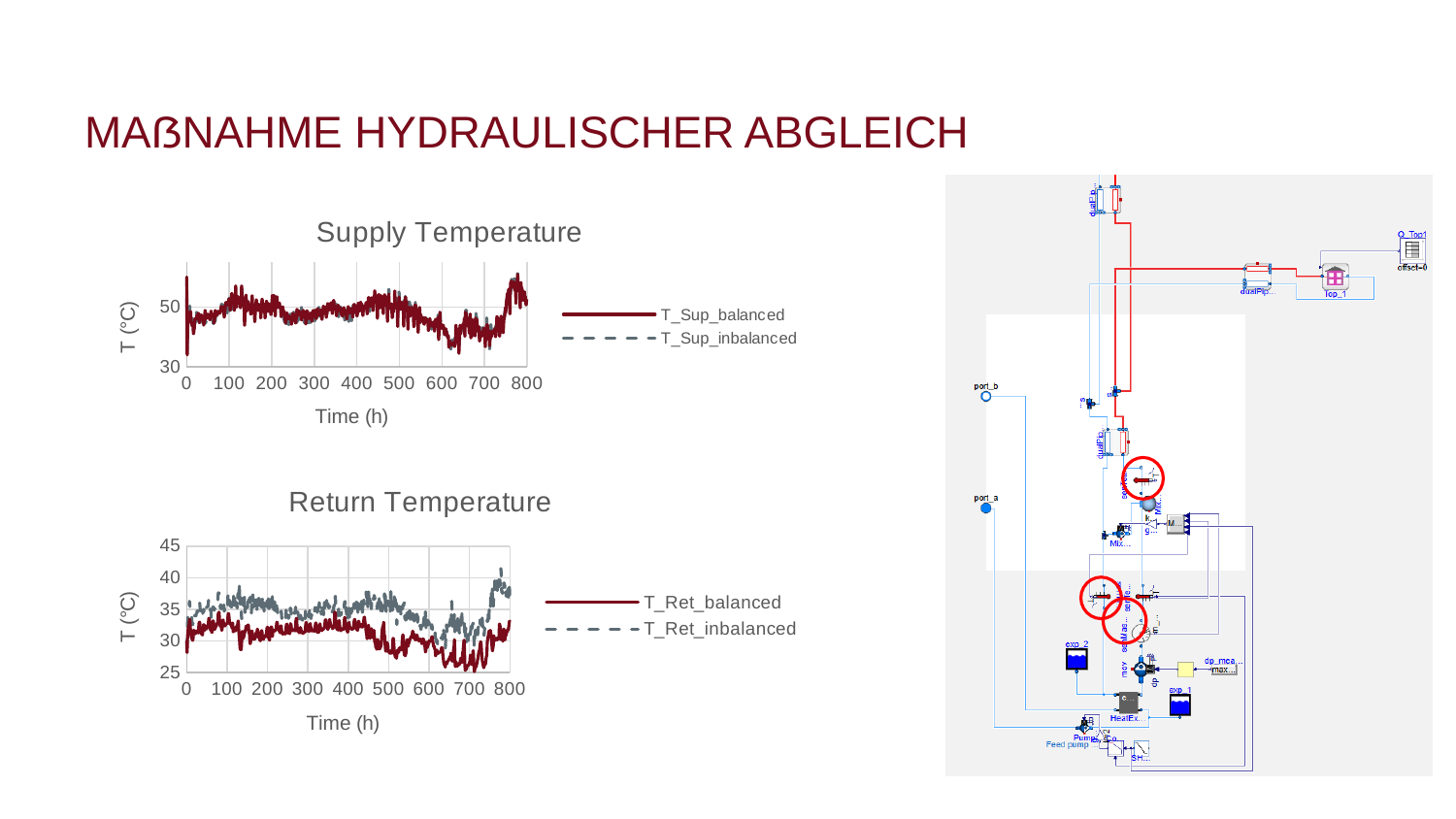
What are the two legend entries of the Return Temperature chart? T_Ret_balanced and T_Ret_inbalanced What is the x-axis label of the Supply Temperature chart? Time (h) In the Return Temperature chart, is the value of T_Ret_balanced at around 600 h greater or less than 40? less How many series does the legend of the Supply Temperature chart list? 2 In the Return Temperature chart, is the value of T_Ret_inbalanced at around 100 h greater or less than 30? greater What kind of chart is the Supply Temperature chart? line chart What is the maximum value shown on the y-axis of the Return Temperature chart? 45 In the Return Temperature chart, which series is higher over most of the time range, T_Ret_balanced or T_Ret_inbalanced? T_Ret_inbalanced What kind of chart is the Return Temperature chart? line chart How many series does the legend of the Return Temperature chart list? 2 In the Supply Temperature chart, is the value of T_Sup_balanced at around 100 h greater or less than 30? greater